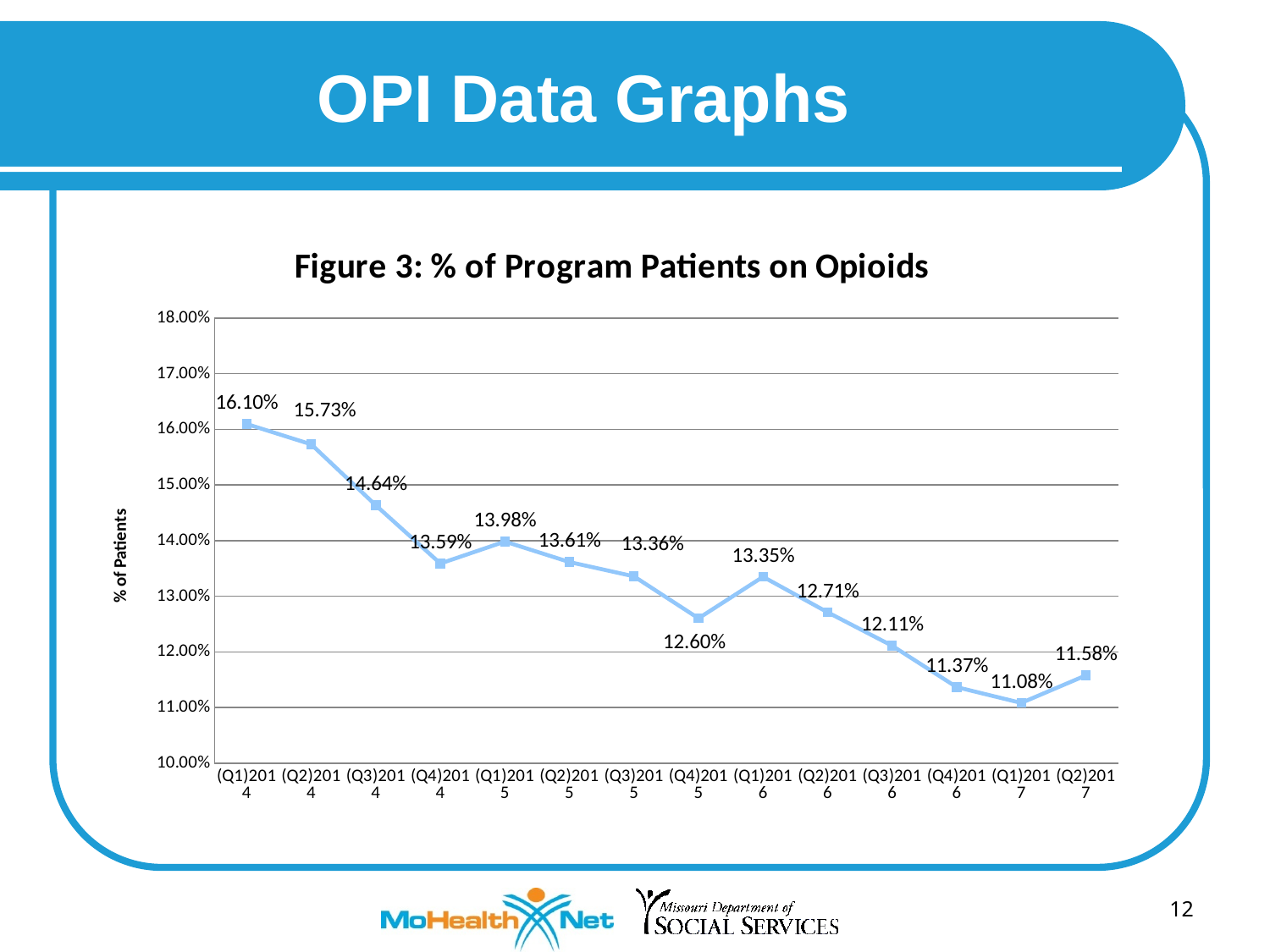
What is the value for (Q1)2014 in Figure 3? 16.10% Do the values in Figure 3 generally rise or fall from (Q1)2014 to (Q2)2017? fall Which quarter has the highest % of patients on opioids in Figure 3? (Q1)2014 What is the value for (Q4)2015 in Figure 3? 12.60% What is the difference between the values for (Q1)2014 and (Q1)2017 in Figure 3? 5.02% How many quarters are plotted in Figure 3? 14 Is the value for (Q3)2014 greater or less than 14.00% in Figure 3? greater What is the title of the chart on the slide? Figure 3: % of Program Patients on Opioids Which is larger in Figure 3, the value for (Q1)2015 or the value for (Q1)2016? (Q1)2015 What kind of chart is Figure 3? line chart Which quarter has the lowest % of patients on opioids in Figure 3? (Q1)2017 What is the value for (Q2)2017 in Figure 3? 11.58%